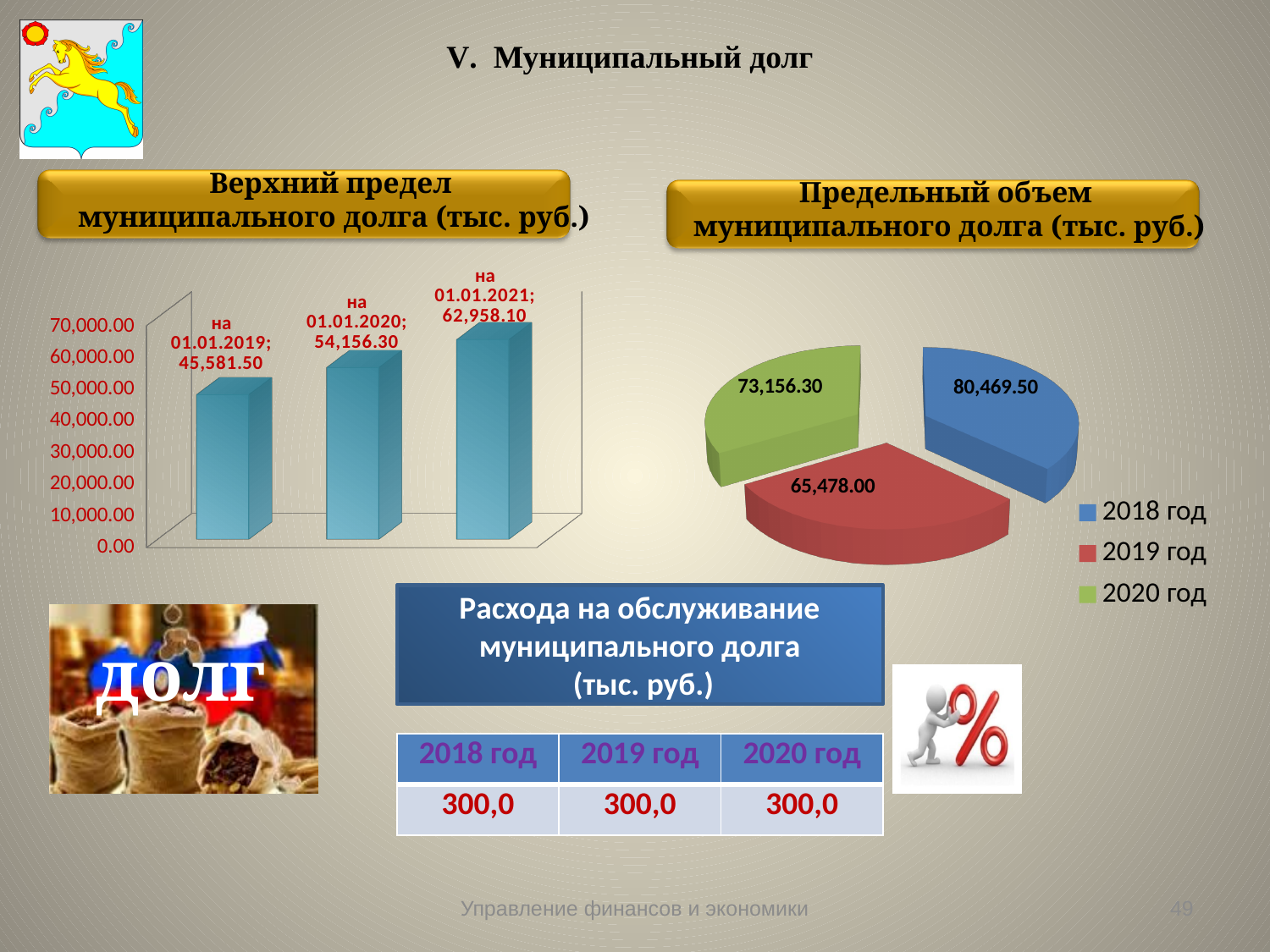
In the bar chart 'Верхний предел муниципального долга (тыс. руб.)', what is the value for на 01.01.2020? 54,156.30 In the pie chart 'Предельный объем муниципального долга (тыс. руб.)', what is the value for 2019 год? 65,478.00 In the pie chart 'Предельный объем муниципального долга (тыс. руб.)', which is larger: the value for 2020 год or for 2019 год? 2020 год In the pie chart 'Предельный объем муниципального долга (тыс. руб.)', which year has the largest value? 2018 год In the bar chart 'Верхний предел муниципального долга (тыс. руб.)', do the values rise or fall from 01.01.2019 to 01.01.2021? rise In the bar chart 'Верхний предел муниципального долга (тыс. руб.)', what is the difference between the values for на 01.01.2021 and на 01.01.2019? 17,376.60 How many bars are shown in the bar chart 'Верхний предел муниципального долга (тыс. руб.)'? 3 How many entries does the legend of the pie chart 'Предельный объем муниципального долга (тыс. руб.)' list? 3 In the bar chart 'Верхний предел муниципального долга (тыс. руб.)', what is the value for на 01.01.2021? 62,958.10 In the pie chart 'Предельный объем муниципального долга (тыс. руб.)', what is the difference between the values for 2018 год and 2019 год? 14,991.50 In the bar chart 'Верхний предел муниципального долга (тыс. руб.)', which date has the lowest value? на 01.01.2019 In the pie chart 'Предельный объем муниципального долга (тыс. руб.)', what colour is the slice for 2020 год? green